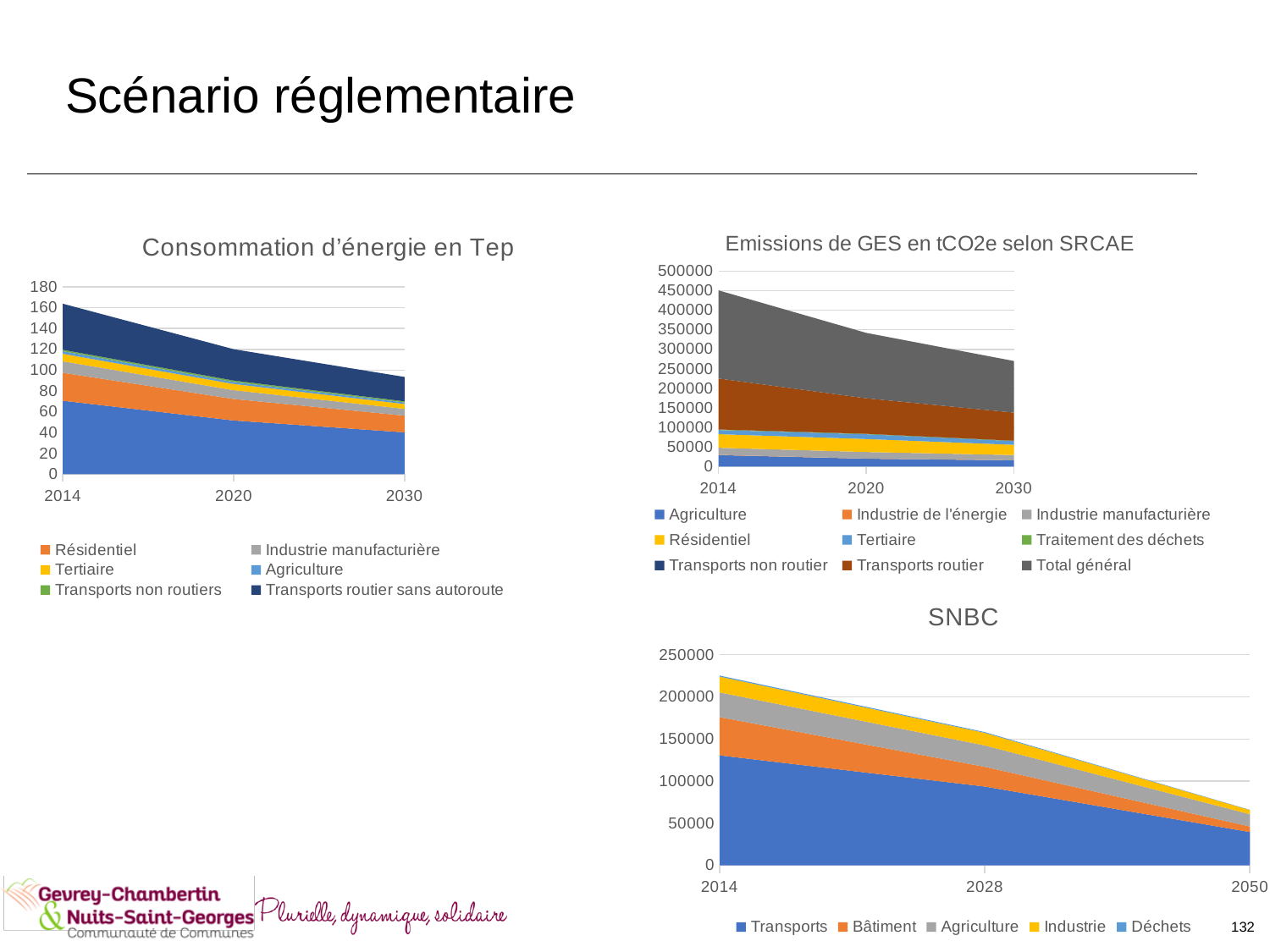
How many series does the legend of the 'Emissions de GES en tCO2e selon SRCAE' chart list? 9 Which years are labelled on the x axis of the 'SNBC' chart? 2014, 2028, 2050 What kind of chart is the 'Consommation d’énergie en Tep' chart? Area chart In the 'Emissions de GES en tCO2e selon SRCAE' chart, is the top of the stacked area in 2014 greater or less than 400000? greater In the 'Consommation d’énergie en Tep' chart, is the total value in 2014 greater or less than 140? greater How many series does the legend of the 'Consommation d’énergie en Tep' chart list? 6 In the 'Consommation d’énergie en Tep' chart, is the total value in 2030 greater or less than 120? less In the 'Consommation d’énergie en Tep' chart, does the total consumption rise or fall from 2014 to 2030? Fall How many years are shown on the x axis of the 'Consommation d’énergie en Tep' chart? 3 In the 'Emissions de GES en tCO2e selon SRCAE' chart, do the emissions rise or fall between 2014 and 2030? Fall How many series does the legend of the 'SNBC' chart list? 5